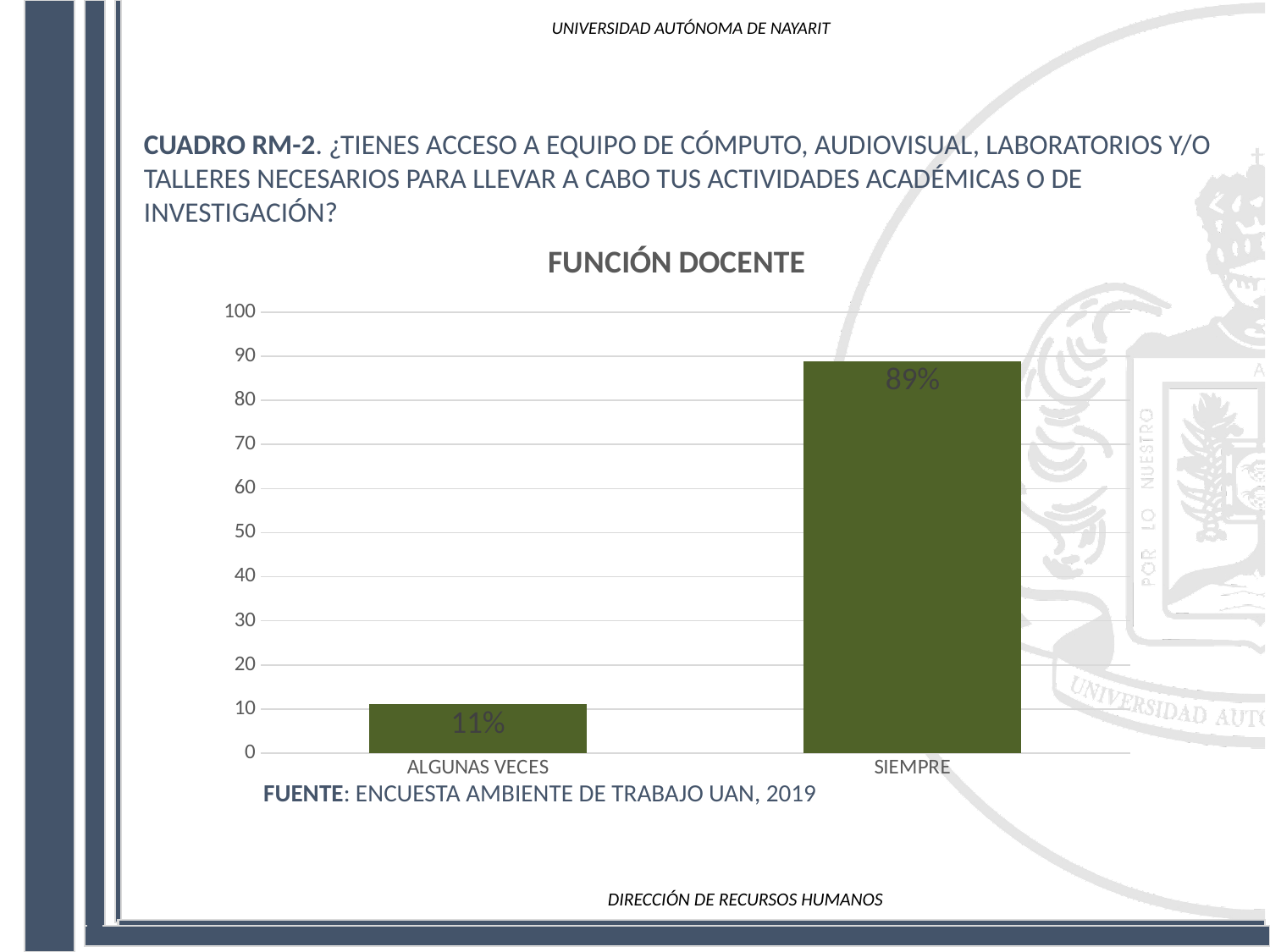
What kind of chart is shown on the slide? bar chart Is the value for SIEMPRE greater or less than 80? greater Is the value for ALGUNAS VECES greater or less than 20? less Which category has the lowest value? ALGUNAS VECES Which category has the highest value? SIEMPRE What is the difference between the values for SIEMPRE and ALGUNAS VECES? 78% How many categories are shown on the x axis? 2 What is the source cited below the chart? ENCUESTA AMBIENTE DE TRABAJO UAN, 2019 Which is larger, the value for ALGUNAS VECES or the value for SIEMPRE? SIEMPRE What is the title of the chart? FUNCIÓN DOCENTE What is the value for ALGUNAS VECES? 11% What is the value for SIEMPRE? 89%